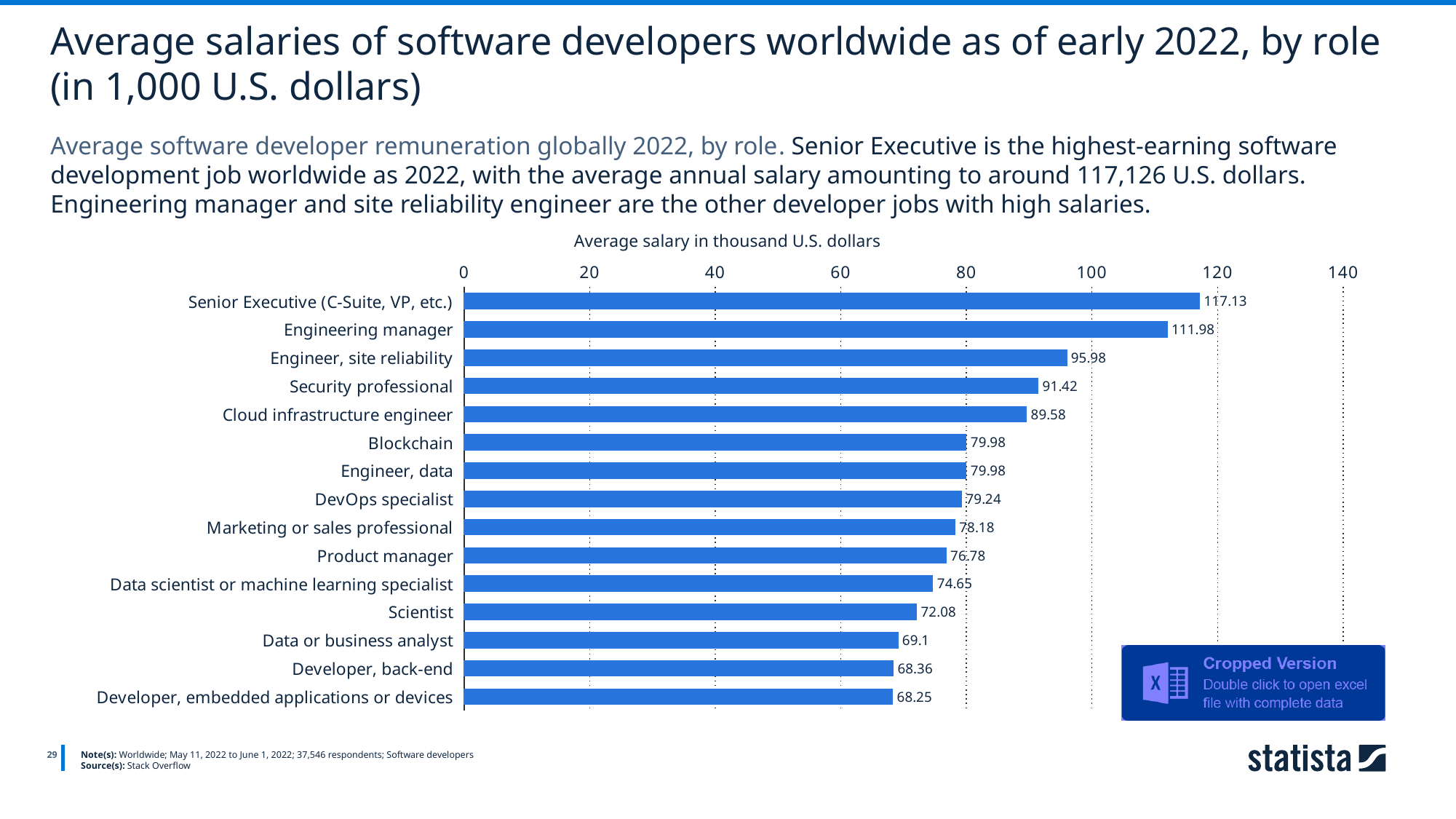
What is the difference between the average salary of Senior Executive (C-Suite, VP, etc.) and Engineering manager? 5.15 Is the value for Data or business analyst greater or less than 80? less Which role has the lowest average salary? Developer, embedded applications or devices Which role has the highest average salary? Senior Executive (C-Suite, VP, etc.) What is the average salary for Security professional? 91.42 What is the average salary for Engineering manager? 111.98 How many roles are shown in the chart? 15 What is the average salary for Scientist? 72.08 Which has a higher average salary, Product manager or DevOps specialist? DevOps specialist What kind of chart is shown on the slide? bar chart What is the axis title shown above the chart? Average salary in thousand U.S. dollars What is the difference between the average salary of Engineer, site reliability and Cloud infrastructure engineer? 6.4